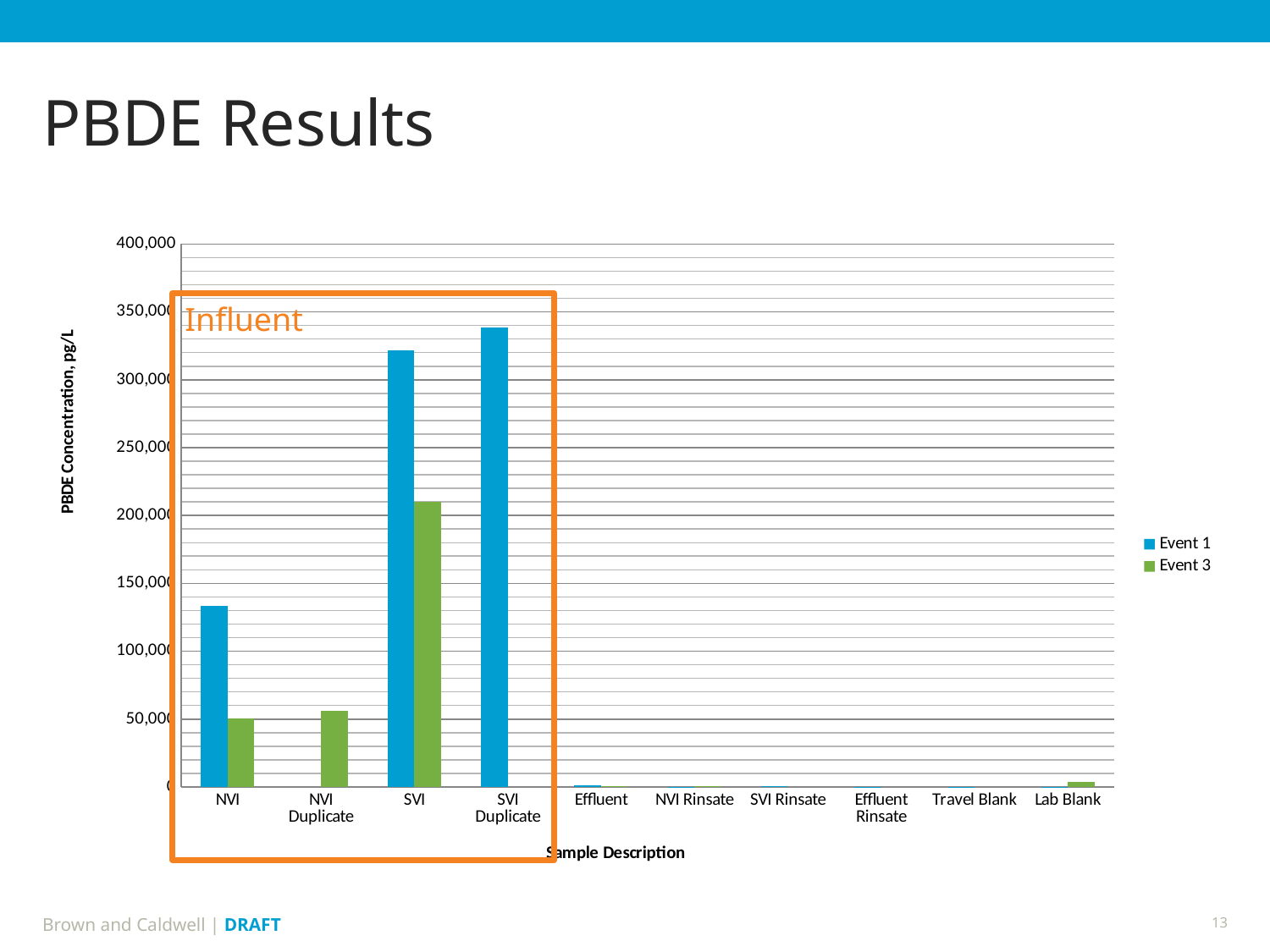
How many series does the legend list? 2 Is the Event 1 value for SVI greater or less than 300,000? greater Which is larger for SVI: the Event 1 value or the Event 3 value? Event 1 Which category has the highest Event 1 value? SVI Duplicate What is the label of the y axis? PBDE Concentration, pg/L How many sample description categories are shown on the x axis? 10 Which category has the highest Event 3 value? SVI What kind of chart is shown on the slide? bar chart Is the Event 3 value for NVI greater or less than 100,000? less Is the Event 1 value for NVI greater or less than 150,000? less What label is written inside the orange box highlighting the first four categories? Influent